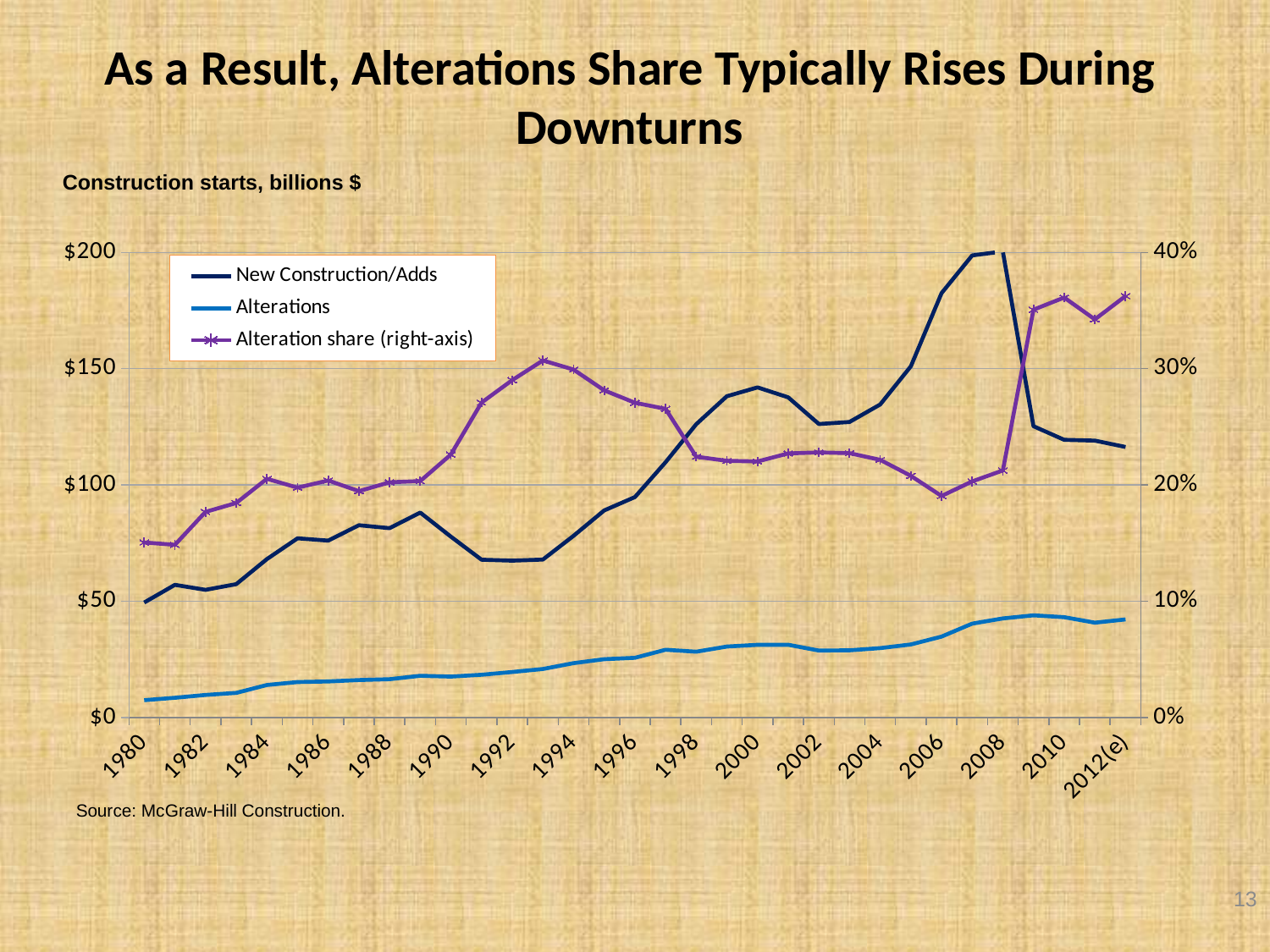
Is the Alteration share in 2010 greater or less than 30%? greater Is the Alteration share in 1980 greater or less than 10%? greater Is the value for New Construction/Adds in 1990 greater or less than $100? less Which series is plotted against the right-hand axis? Alteration share What kind of chart is shown on the slide? Line chart How many series does the legend list? 3 What is the title of the slide? As a Result, Alterations Share Typically Rises During Downturns In 2000, which is larger: New Construction/Adds or Alterations? New Construction/Adds Does the Alterations series generally rise or fall from 1980 to 2010? Rise